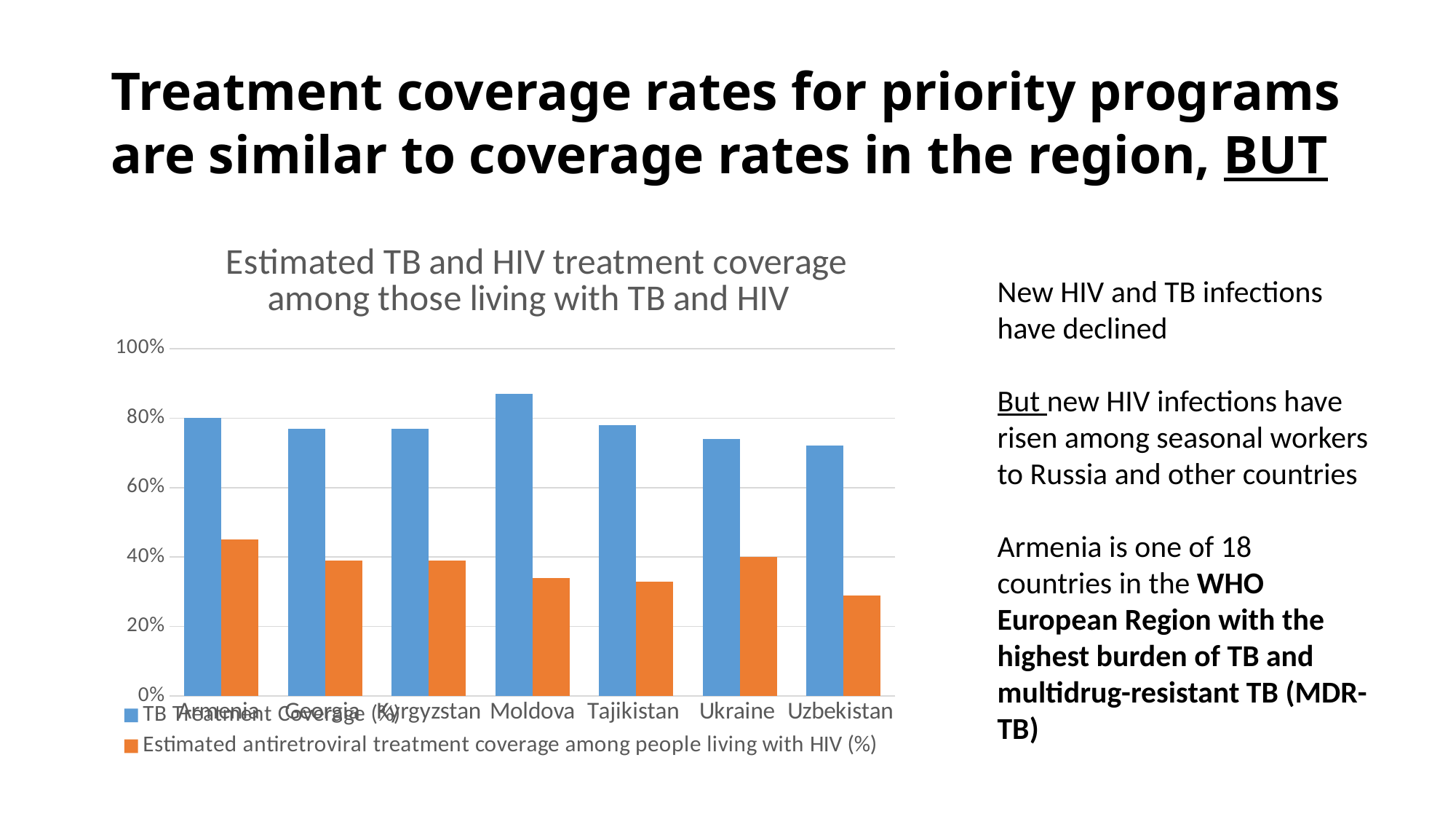
Which is larger, the TB Treatment Coverage (%) for Moldova or for Armenia? Moldova How many series does the chart's legend list? 2 Is the estimated antiretroviral treatment coverage for Armenia greater or less than 40%? greater Is the TB Treatment Coverage (%) for Moldova greater or less than 80%? greater Is the estimated antiretroviral treatment coverage for Uzbekistan greater or less than 40%? less What kind of chart is shown on the slide? bar chart Which country has the lowest estimated antiretroviral treatment coverage among people living with HIV (%)? Uzbekistan How many countries are shown on the x axis of the chart? 7 Which country has the highest TB Treatment Coverage (%)? Moldova Which country has the highest estimated antiretroviral treatment coverage among people living with HIV (%)? Armenia What colour are the bars for the TB Treatment Coverage (%) series? blue